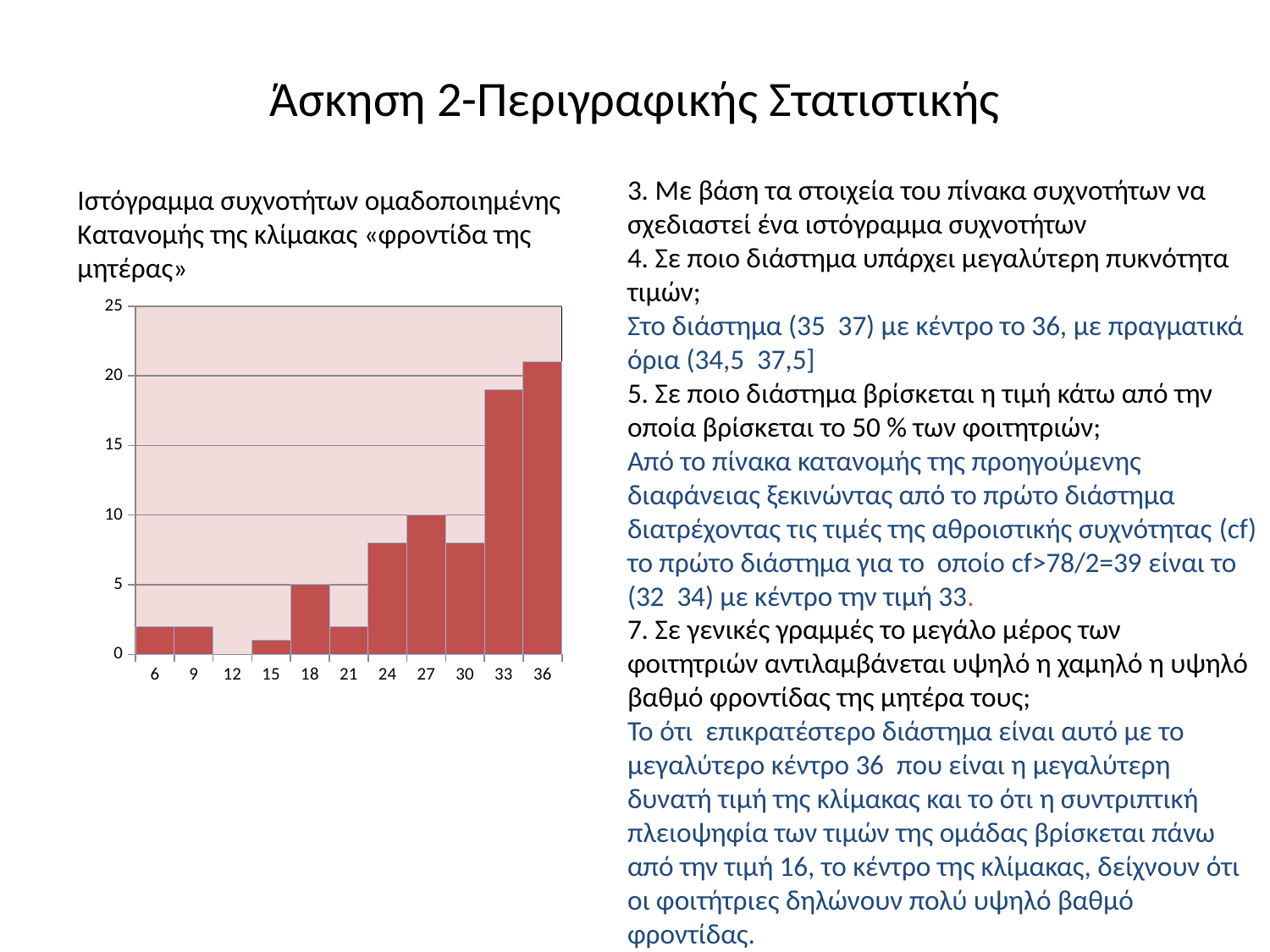
What kind of chart is shown on the slide? bar chart How many categories are shown on the x axis of the chart? 11 What is the value for category 18? 5 Is the value for category 15 greater or less than 5? less Is the value for category 36 greater or less than 20? greater What is the highest tick value shown on the y axis of the chart? 25 Which is larger, the value for category 18 or the value for category 21? 18 Is the value for category 33 greater or less than 15? greater Do the values generally rise or fall from left to right along the x axis? rise Which category has the highest bar in the chart? 36 What is the value for category 27? 10